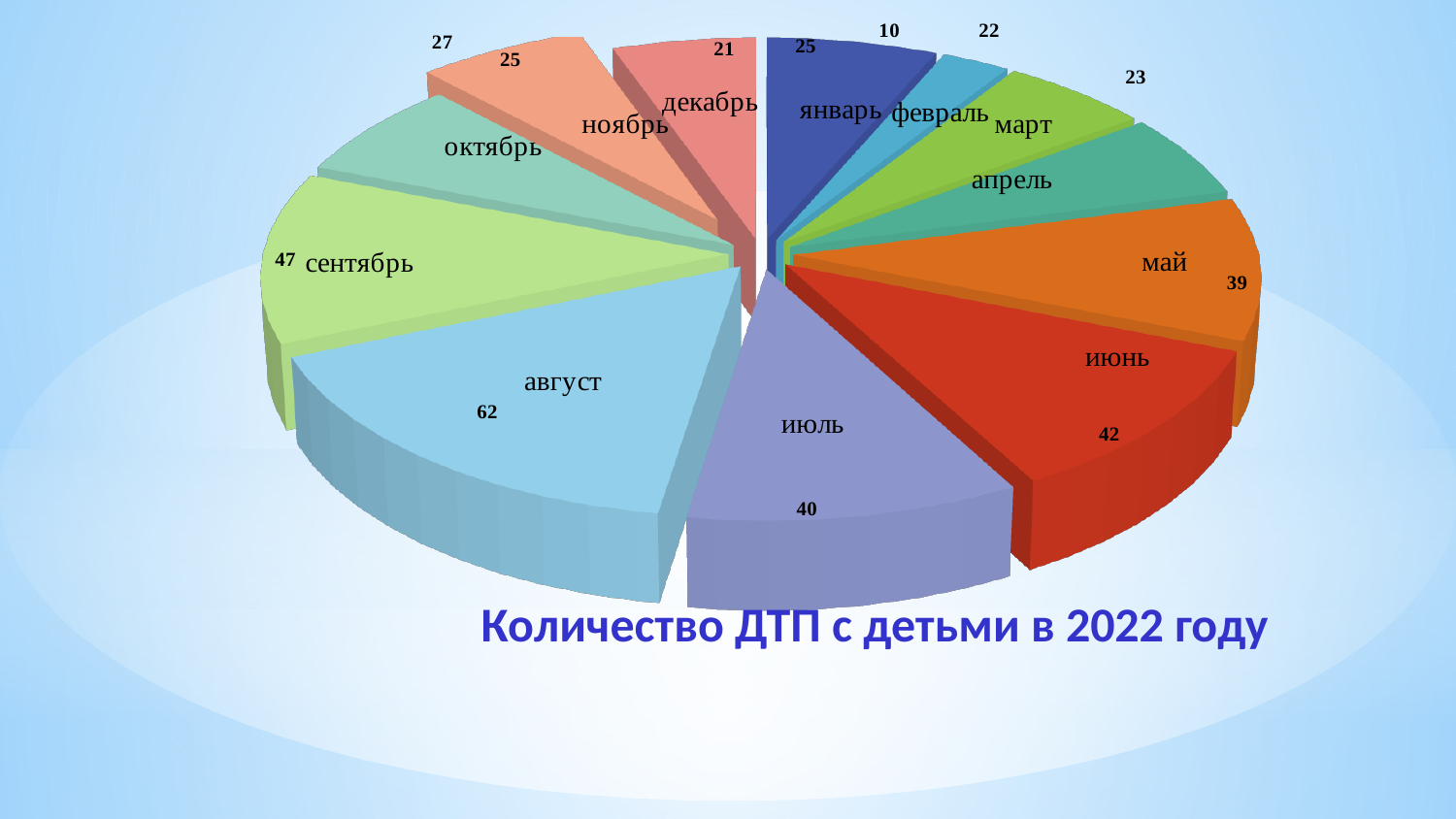
What is the value for сентябрь? 47 Which month has the smallest slice? февраль What is the value for август? 62 What is the difference between the values for июнь and май? 3 What is the difference between the values for август and сентябрь? 15 Which is larger, the value for июнь or the value for июль? июнь Which month has the largest slice? август What is the value for февраль? 10 What is the title of the chart? Количество ДТП с детьми в 2022 году How many slices (months) does the pie chart have? 12 What kind of chart is shown on the slide? Pie chart What is the value for май? 39